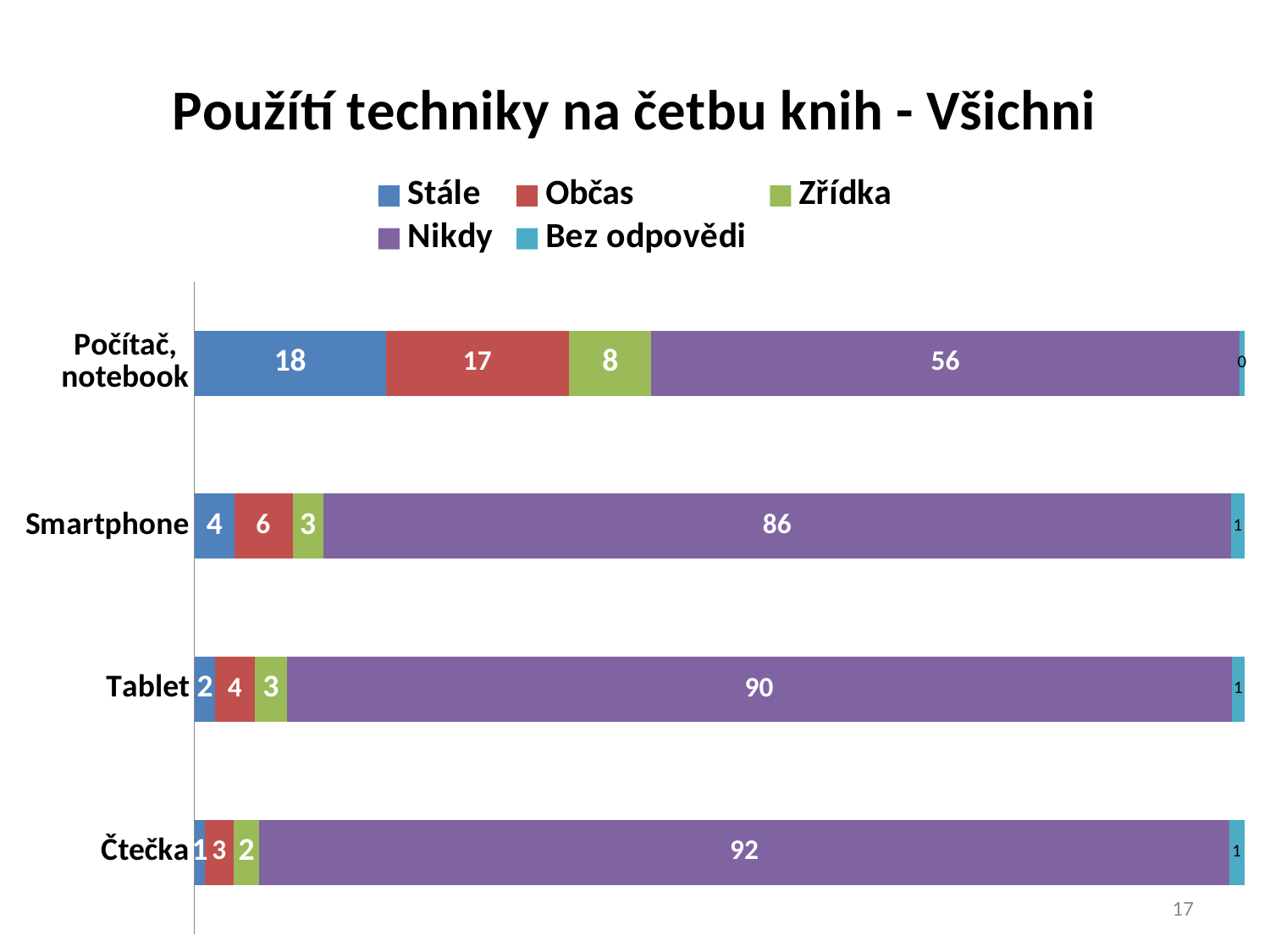
What is the title of the chart? Použítí techniky na četbu knih - Všichni What type of chart is shown on the slide? Stacked bar chart What is the value of Občas for Tablet? 4 What is the value of Zřídka for Čtečka? 2 Which category has the highest value for Nikdy? Čtečka How many categories are shown on the chart? 4 Which is larger: the Občas value for Počítač, notebook or the Občas value for Smartphone? Počítač, notebook What is the difference between the Nikdy values for Tablet and Smartphone? 4 How many series does the legend list? 5 Which category has the lowest value for Stále? Čtečka What is the value of Stále for Počítač, notebook? 18 What is the value of Nikdy for Smartphone? 86